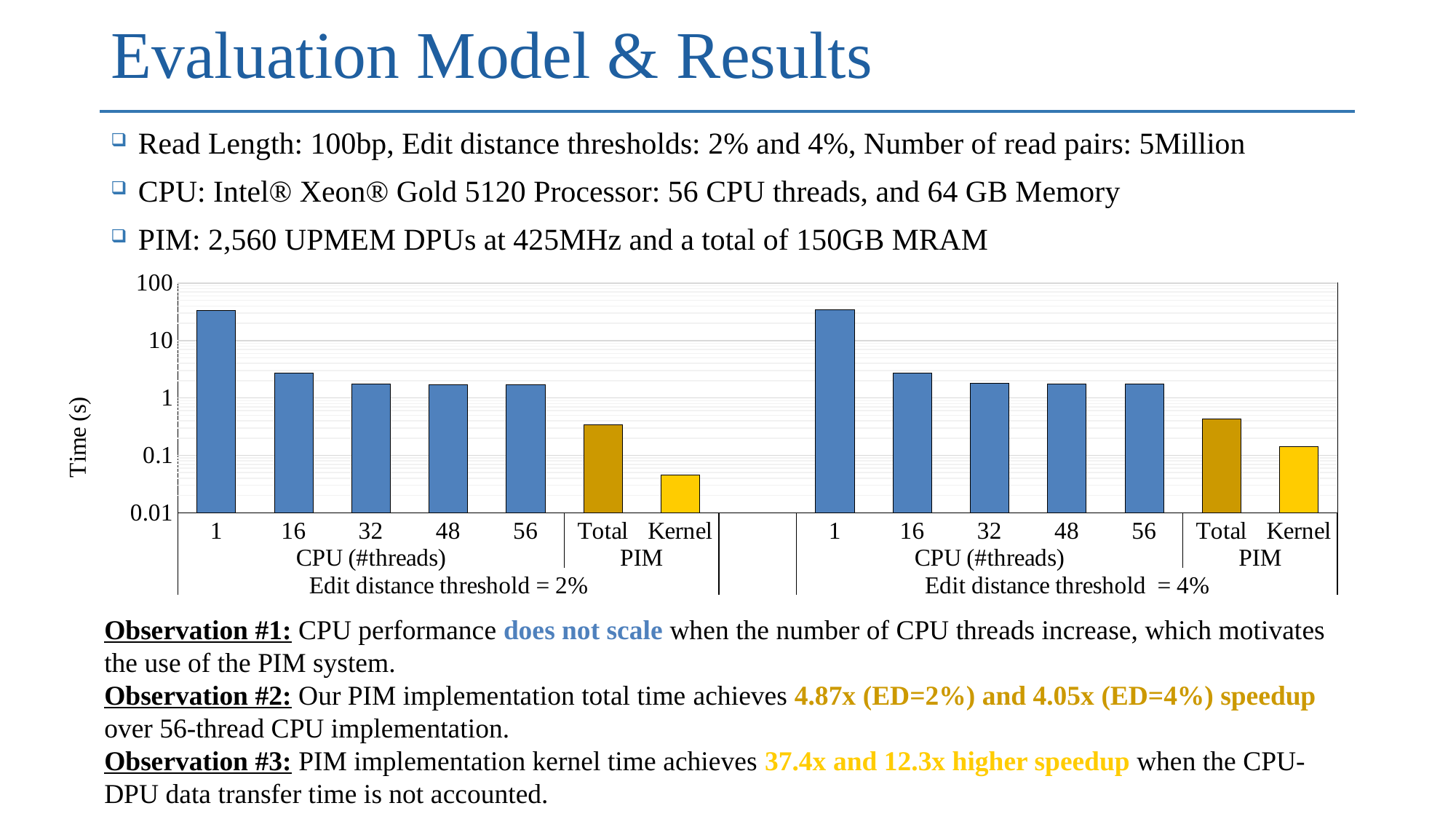
Is the time for PIM Total at Edit distance threshold = 4% greater or less than 1 s? less Which is larger: the PIM Kernel time at Edit distance threshold = 2% or at Edit distance threshold = 4%? Edit distance threshold = 4% What kind of chart is shown on the slide? bar chart In the Edit distance threshold = 2% group, which bar has the highest time? CPU 1 thread Is the time for PIM Kernel at Edit distance threshold = 2% greater or less than 0.1 s? less Is the time for CPU with 56 threads at Edit distance threshold = 4% greater or less than 1 s? greater What is the label of the y axis of the chart? Time (s) In the Edit distance threshold = 2% group, which bar has the lowest time? PIM Kernel How many bars are plotted in the Edit distance threshold = 2% group? 7 In the Edit distance threshold = 4% group, which bar has the lowest time? PIM Kernel In the Edit distance threshold = 2% group, does the CPU time rise or fall as the number of threads increases from 1 to 56? fall